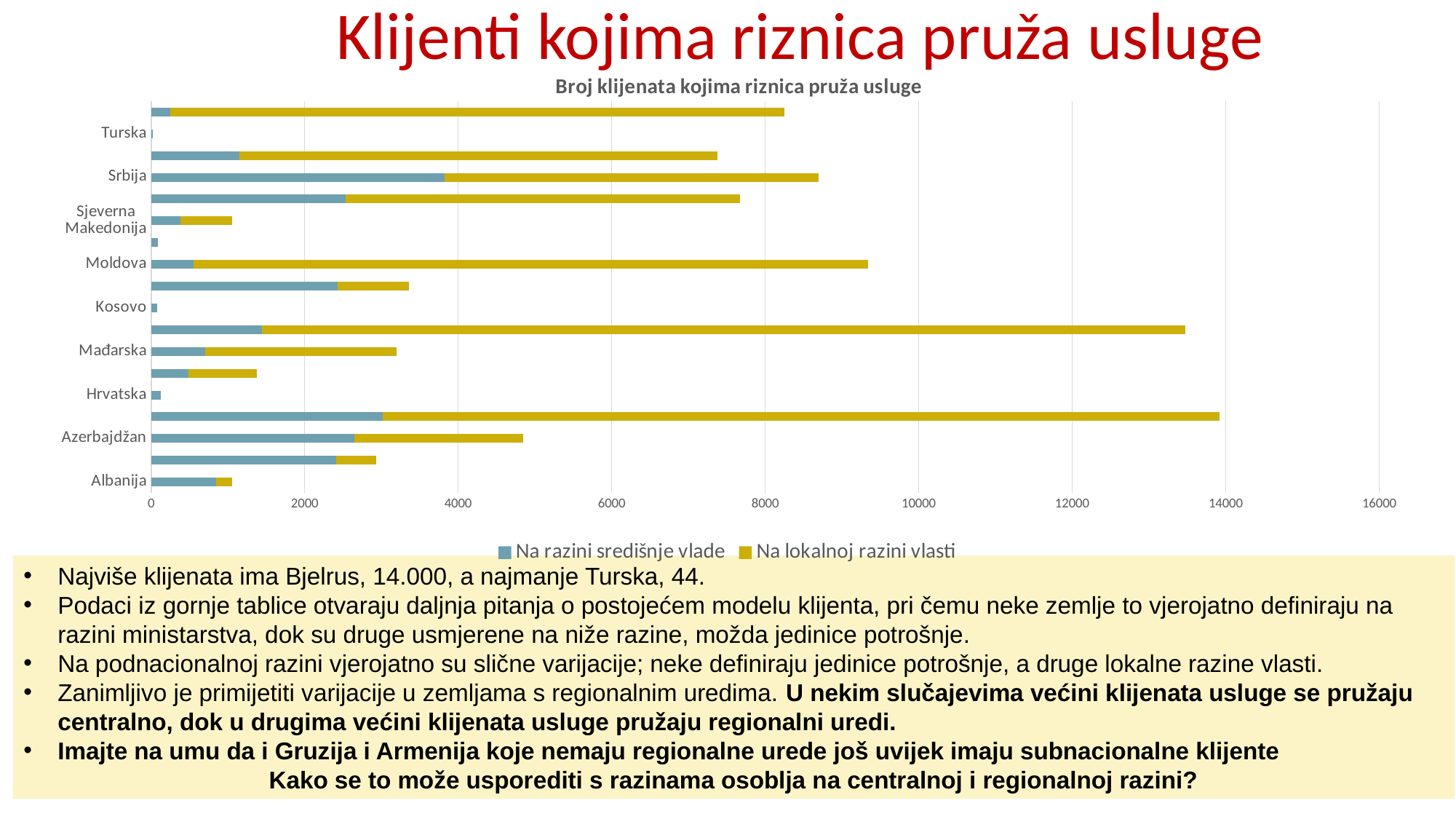
Which has a larger total bar, Azerbajdžan or Albanija? Azerbajdžan What is the title of the chart? Broj klijenata kojima riznica pruža usluge Is the total value of the bar for Mađarska greater or less than 4000? less What kind of chart is shown on the slide? Bar chart Is the total value of the bar for Albanija greater or less than 2000? less Is the total value of the bar for Azerbajdžan greater or less than 4000? greater How many series does the chart legend list? 2 Which series is shown in yellow in the chart? Na lokalnoj razini vlasti Which has a larger total bar, Moldova or Mađarska? Moldova